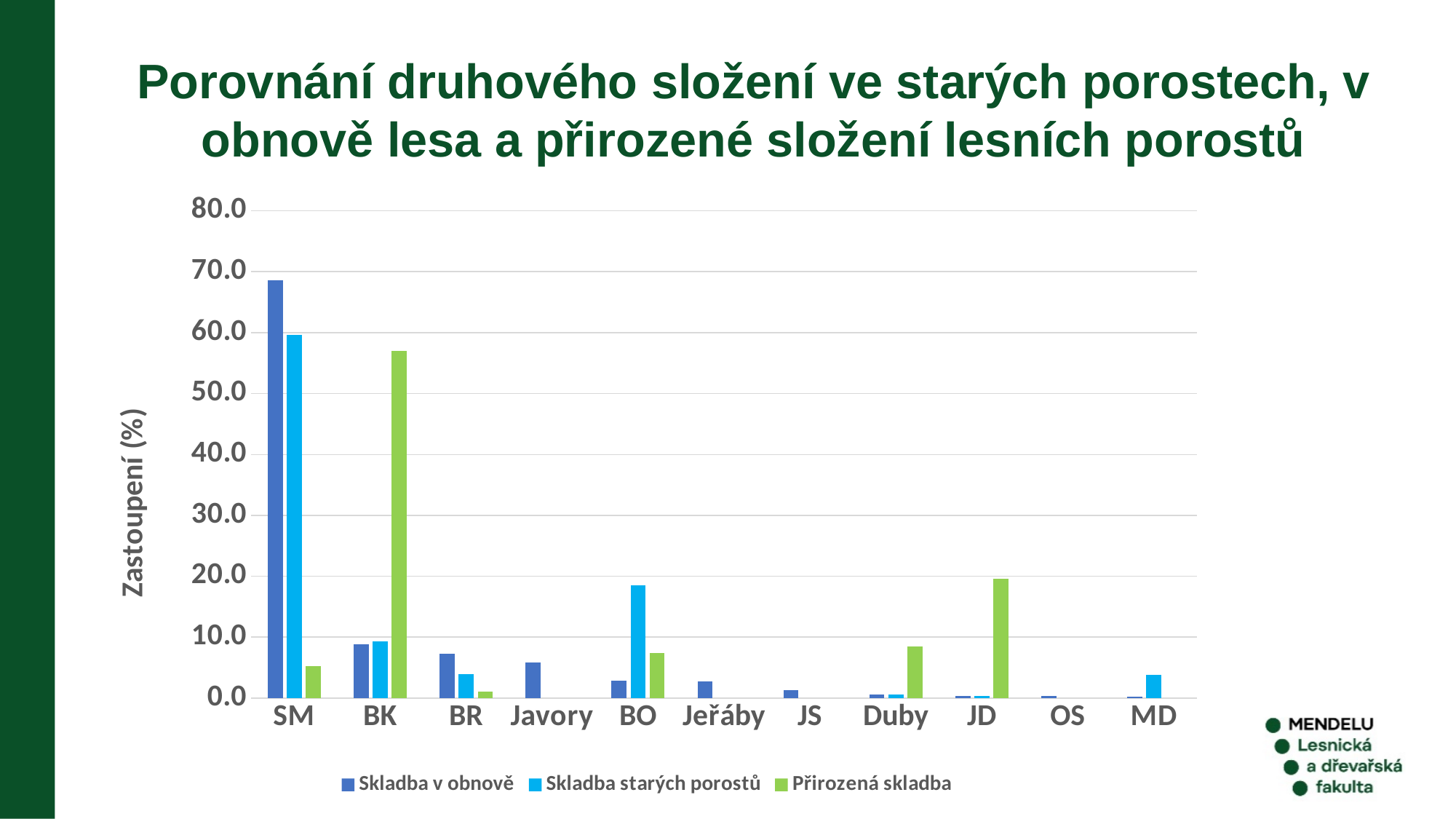
How many tree species categories are shown on the x axis? 11 Which category has the highest value for the series Skladba v obnově? SM What kind of chart is shown on the slide? bar chart Is the value for BO in the series Skladba starých porostů greater or less than 10.0? greater For SM, which series has the larger value: Skladba v obnově or Skladba starých porostů? Skladba v obnově For the series Přirozená skladba, which is larger: the value for JD or the value for Duby? JD Is the value for BK in the series Přirozená skladba greater or less than 50.0? greater Which category has the highest value for the series Přirozená skladba? BK Is the value for SM in the series Skladba v obnově greater or less than 60.0? greater Which category has the highest value for the series Skladba starých porostů? SM How many series does the legend list? 3 What is the title of the vertical axis? Zastoupení (%)